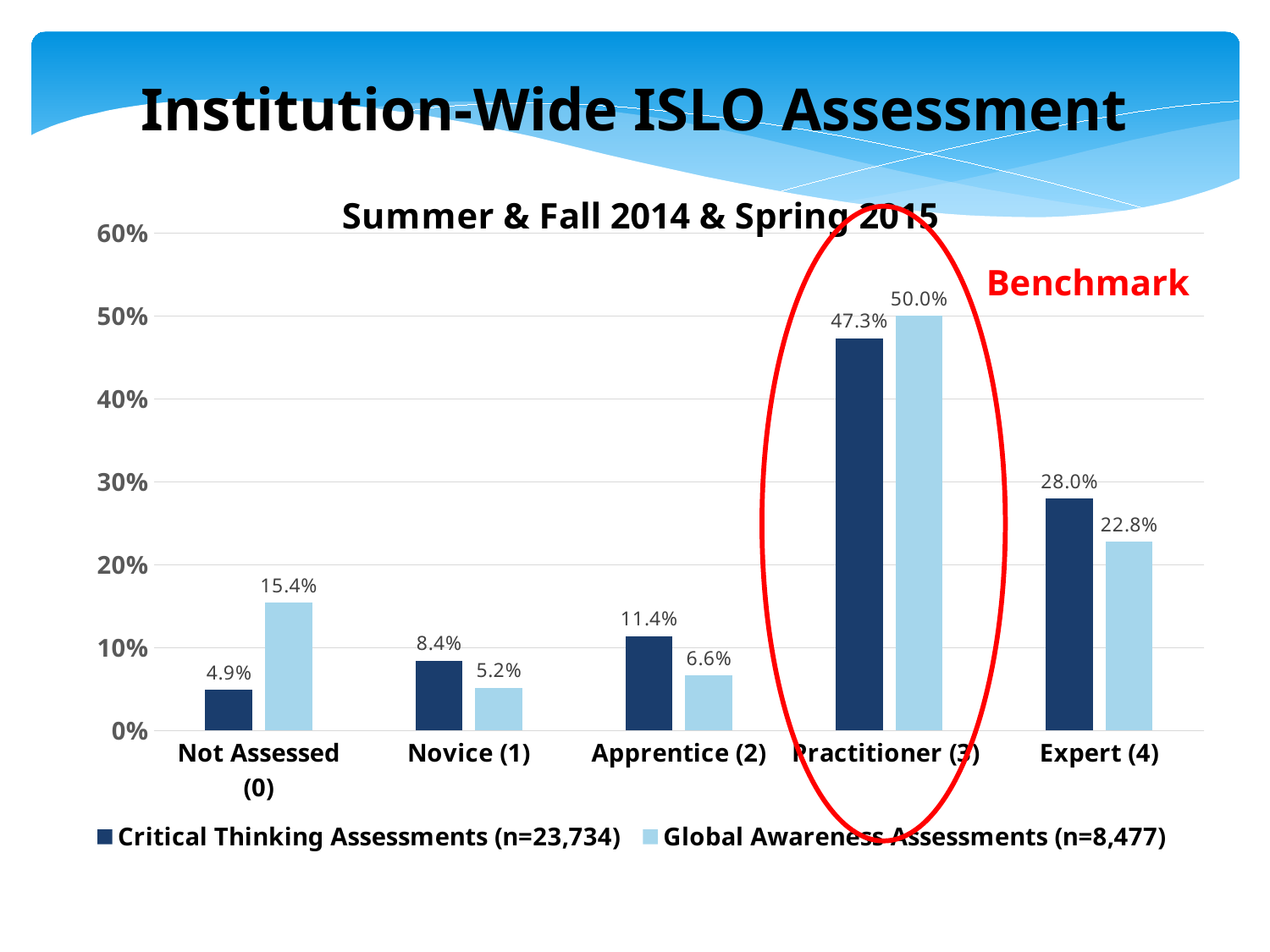
What is the sample size (n) given in the legend for Critical Thinking Assessments? n=23,734 Which category has the lowest Critical Thinking Assessments value? Not Assessed (0) What is the Critical Thinking Assessments value for Practitioner (3)? 47.3% What is the title of the chart? Summer & Fall 2014 & Spring 2015 What is the Global Awareness Assessments value for Expert (4)? 22.8% How many series does the legend list? 2 For Apprentice (2), which series has the larger value, Critical Thinking Assessments or Global Awareness Assessments? Critical Thinking Assessments How many categories are shown on the x axis? 5 What is the Global Awareness Assessments value for Not Assessed (0)? 15.4% Which category has the highest Global Awareness Assessments value? Practitioner (3) What kind of chart is shown on the slide? Bar chart What is the difference between the Critical Thinking and Global Awareness values for Expert (4)? 5.2%